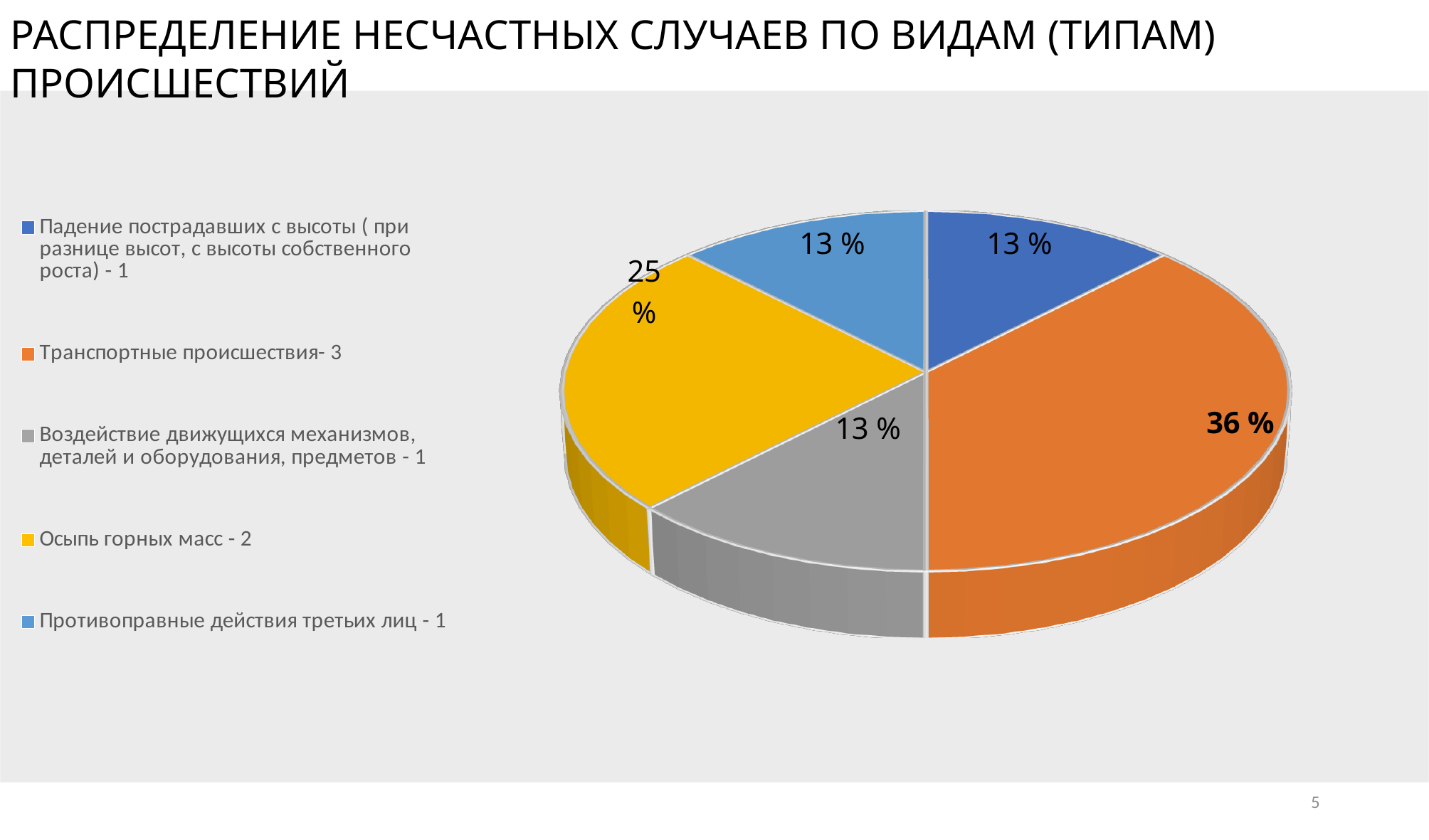
What share of the pie does Транспортные происшествия take? 36 % What is the difference in percentage points between the Транспортные происшествия slice and the Осыпь горных масс slice? 11 How many slices does the pie chart have? 5 What kind of chart is shown on the slide? Pie chart According to the legend, how many cases are listed for Осыпь горных масс? 2 Which is larger: the slice for Транспортные происшествия or the slice for Осыпь горных масс? Транспортные происшествия What share of the pie does Противоправные действия третьих лиц take? 13 % Which category has the largest slice of the pie? Транспортные происшествия What colour is the slice for Осыпь горных масс? Yellow What share of the pie does Осыпь горных масс take? 25 % According to the legend, how many cases are listed for Транспортные происшествия? 3